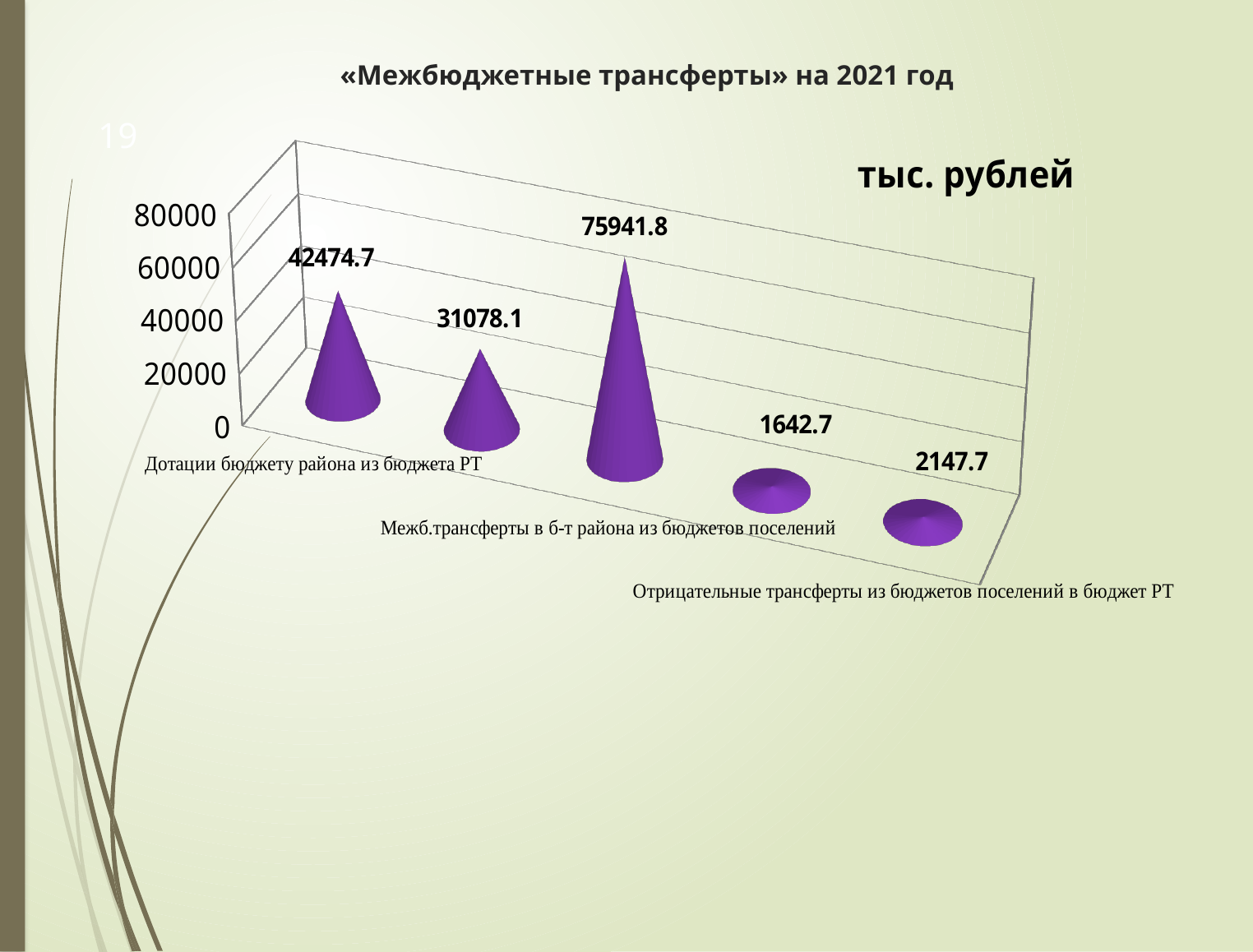
What is the difference between the value for «Отрицательные трансферты из бюджетов поселений в бюджет РТ» (2147.7) and the fourth bar (1642.7)? 505.0 What is the difference between the values for «Межб.трансферты в б-т района из бюджетов поселений» and «Дотации бюджету района из бюджета РТ»? 33467.1 What is the value for «Межб.трансферты в б-т района из бюджетов поселений»? 75941.8 How many bars are plotted on the chart? 5 Which category has the highest value? Межб.трансферты в б-т района из бюджетов поселений What is the smallest value shown on the chart? 1642.7 What is the value for «Отрицательные трансферты из бюджетов поселений в бюджет РТ»? 2147.7 What is the title of the chart? тыс. рублей What is the value of the second bar from the left? 31078.1 What kind of chart is shown on the slide? bar chart What is the value for «Дотации бюджету района из бюджета РТ»? 42474.7 Which is larger: the value for «Дотации бюджету района из бюджета РТ» or for «Отрицательные трансферты из бюджетов поселений в бюджет РТ»? Дотации бюджету района из бюджета РТ